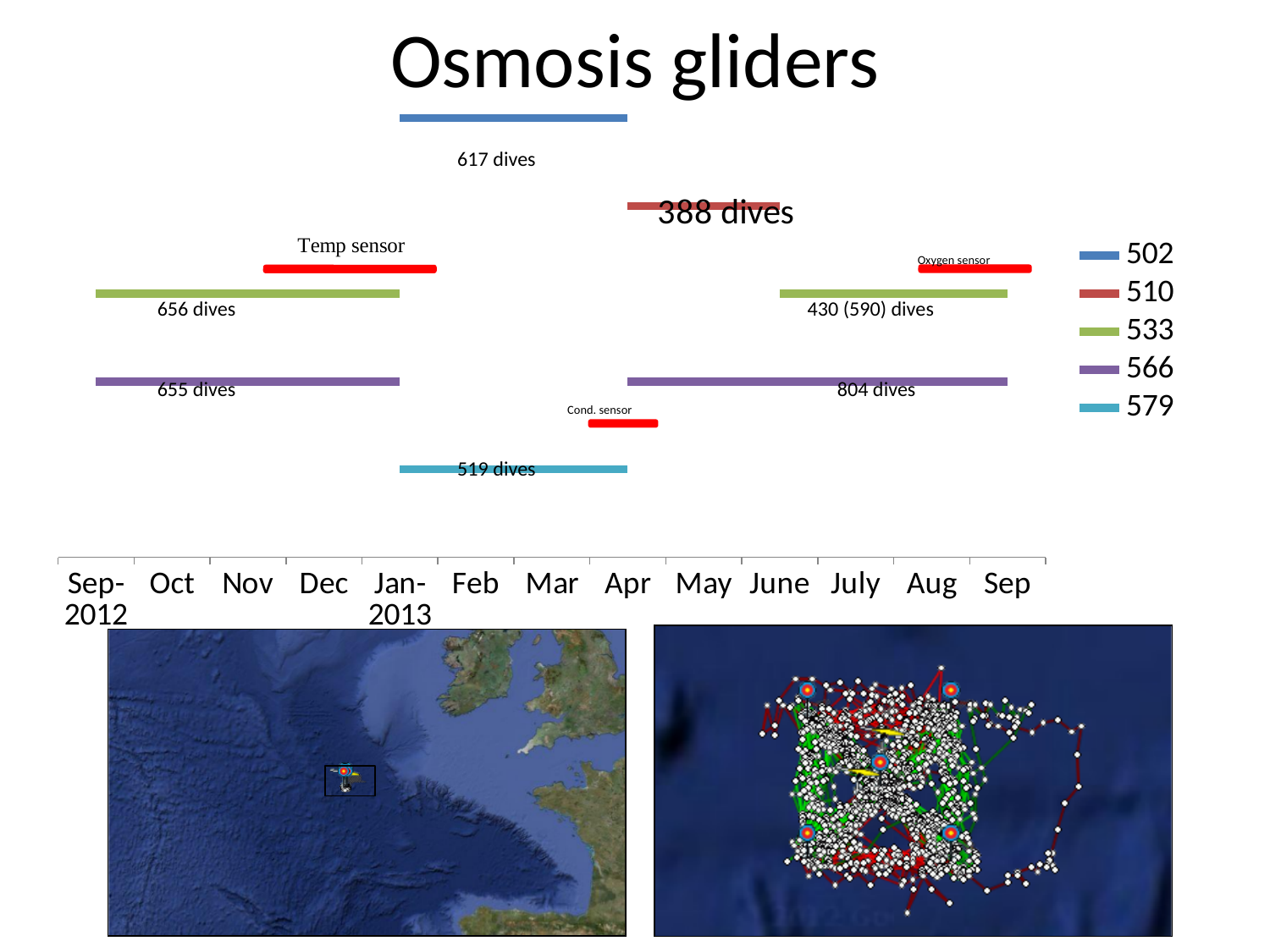
Which glider series is shown in purple in the legend? 566 What is the title of the chart? Osmosis gliders Which dive count label is the lowest on the chart? 388 dives How many dives are labelled on the bar for glider 502? 617 dives How many dives are labelled on the bar for glider 579? 519 dives How many glider series does the legend list? 5 Which has more dives, the bar for glider 502 or the bar for glider 579? glider 502 What is the difference between the 804 dives and 655 dives labels for glider 566? 149 Which dive count label is the highest on the chart? 804 dives How many dives are labelled on the bar for glider 510? 388 dives How many month labels are shown on the x axis? 13 What kind of chart is shown on the slide? line chart